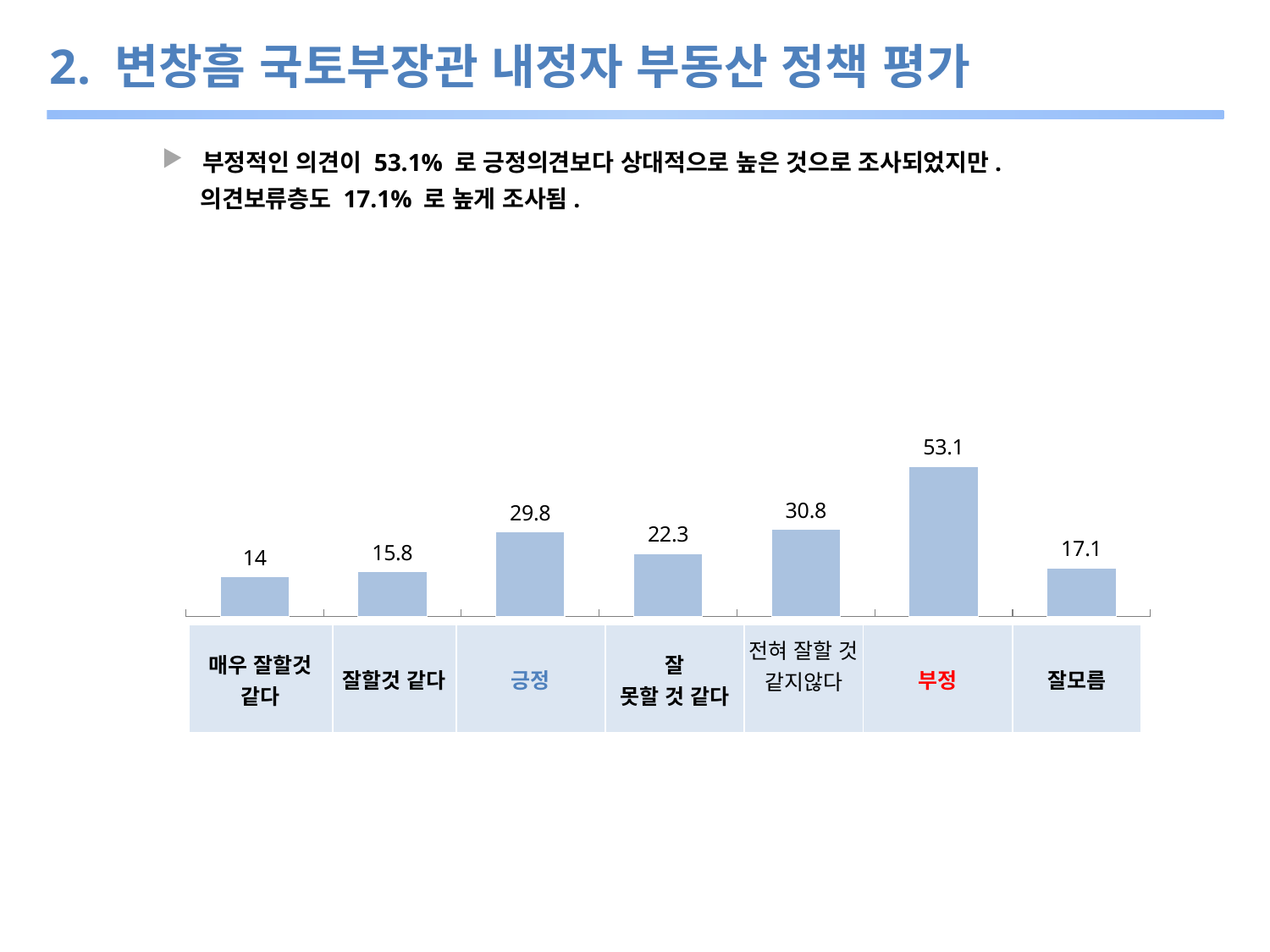
What is the difference between the values for 부정 and 긍정? 23.3 What is the value for 전혀 잘할 것 같지않다? 30.8 What is the value for 긍정? 29.8 What is the value for 잘모름? 17.1 What is the value for 부정? 53.1 Which category has the lowest value? 매우 잘할것 같다 What kind of chart is shown on the slide? bar chart What is the value for 매우 잘할것 같다? 14 Which category has the highest value? 부정 Which is larger, the value for 잘할것 같다 or the value for 잘 못할 것 같다? 잘 못할 것 같다 How many categories are shown in the chart? 7 What is the difference between the values for 전혀 잘할 것 같지않다 and 잘 못할 것 같다? 8.5